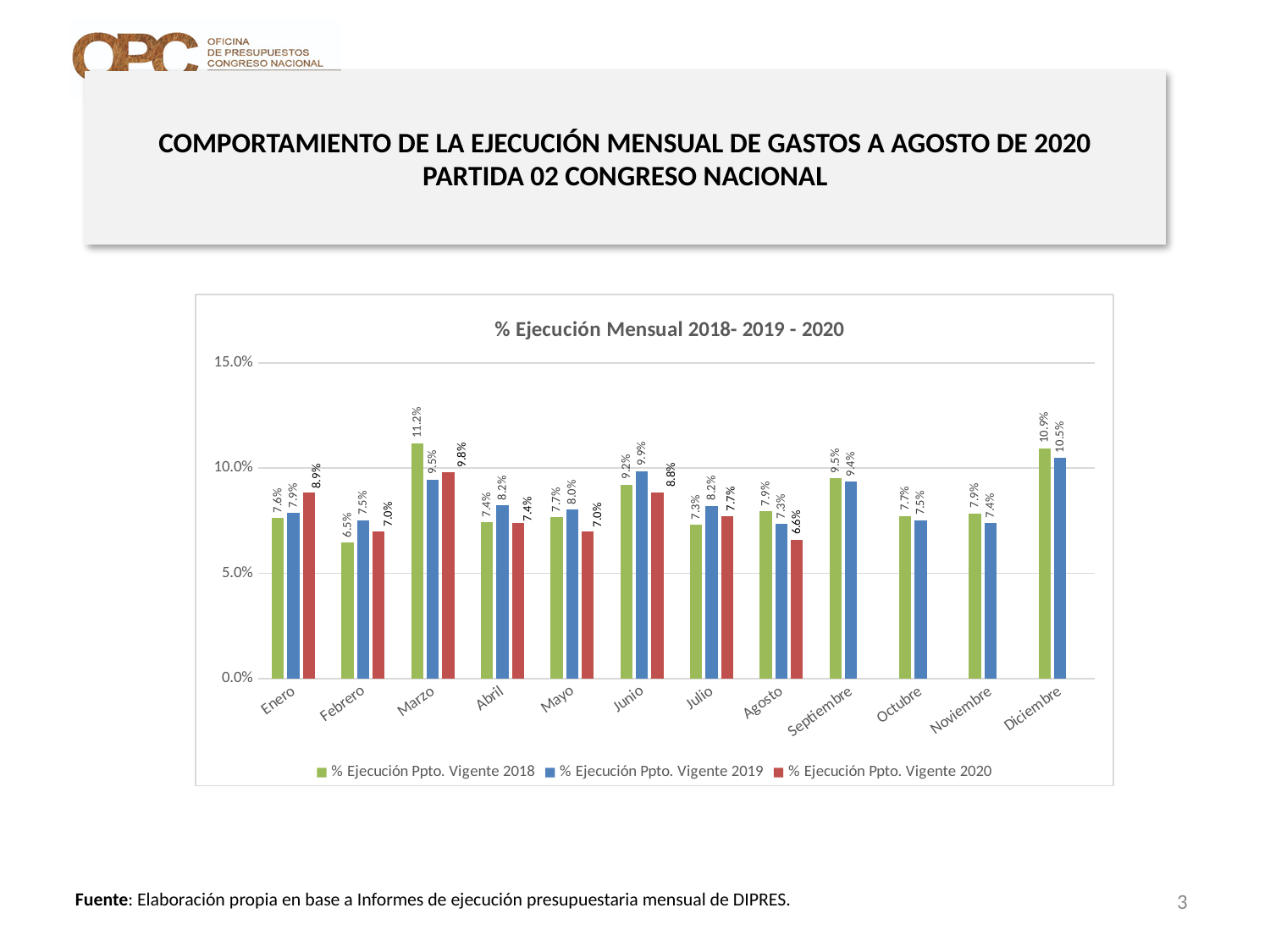
Which is larger in Enero: the 2019 value or the 2020 value? 2020 value (8.9%) What is the value for % Ejecución Ppto. Vigente 2018 in Diciembre? 10.9% Which month has the lowest value for % Ejecución Ppto. Vigente 2020? Agosto What is the title of the chart? % Ejecución Mensual 2018- 2019 - 2020 Which month has the highest value for % Ejecución Ppto. Vigente 2018? Marzo What is the value for % Ejecución Ppto. Vigente 2019 in Junio? 9.9% What kind of chart is shown on the slide? Bar chart How many months are shown on the x axis? 12 What is the value for % Ejecución Ppto. Vigente 2020 in Marzo? 9.8% How many series does the legend list? 3 Is the value for % Ejecución Ppto. Vigente 2018 in Marzo greater or less than 10.0%? greater What is the difference between the 2018 and 2019 values in Marzo? 1.7%